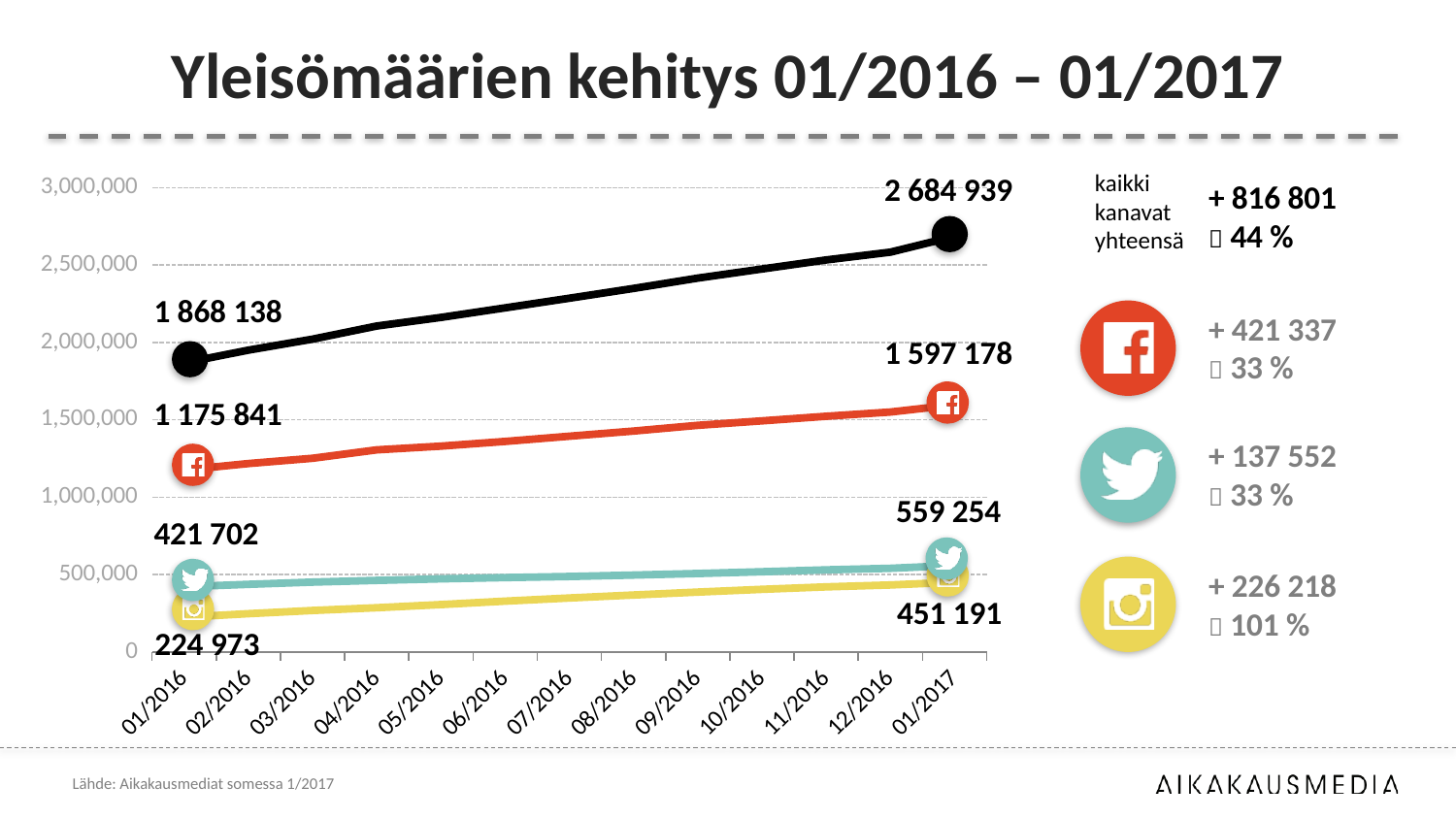
What is the value of the black line (kaikki kanavat yhteensä) at 01/2017? 2 684 939 Which is larger at 01/2017, the Twitter value or the Instagram value? Twitter Does the Instagram line rise or fall from 01/2016 to 01/2017? rise Which channel has the lowest value at 01/2016? Instagram How many months are shown on the x axis? 13 What is the Twitter value at 01/2017? 559 254 What is the Instagram value at 01/2016? 224 973 What type of chart is shown on the slide? line chart Which line has the highest value at 01/2017? the black line (kaikki kanavat yhteensä) Is the Facebook value at 07/2016 greater or less than 1,500,000? less By how much did the Facebook value increase from 01/2016 to 01/2017? 421 337 What is the Facebook value at 01/2016? 1 175 841